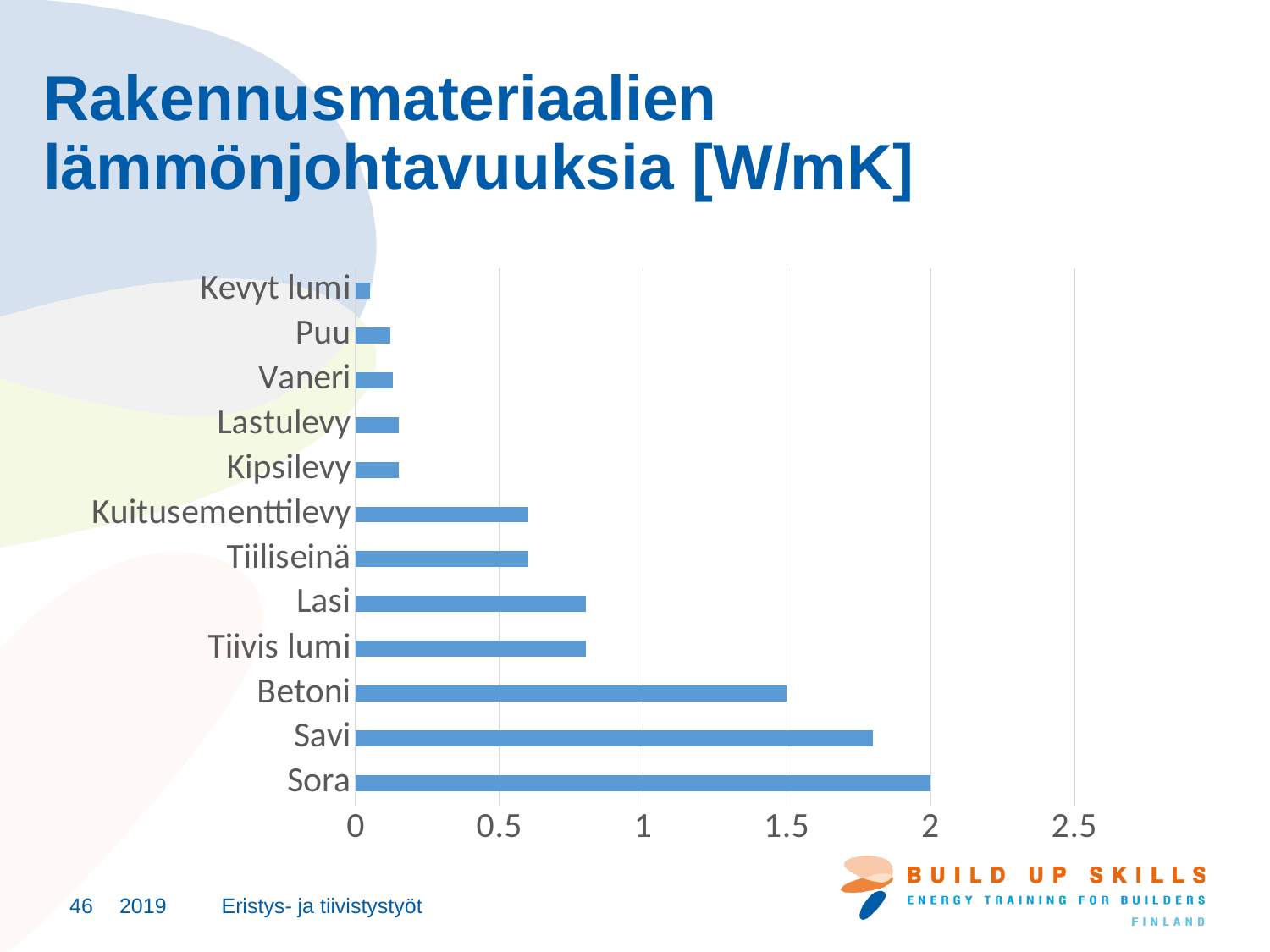
How many materials (categories) are plotted in the chart? 12 Is the value for Savi greater or less than 1.5? greater Which material has the highest value in the chart? Sora What is the title of the slide containing the chart? Rakennusmateriaalien lämmönjohtavuuksia [W/mK] Which material has the lowest value in the chart? Kevyt lumi Is the value for Kuitusementtilevy greater or less than 0.5? greater Which has a larger value, Savi or Betoni? Savi What is the value for Sora? 2 What kind of chart is shown on the slide? bar chart What is the value for Betoni? 1.5 Is the value for Lasi greater or less than 1? less Do the bars get longer or shorter going from the top category (Kevyt lumi) to the bottom category (Sora)? longer